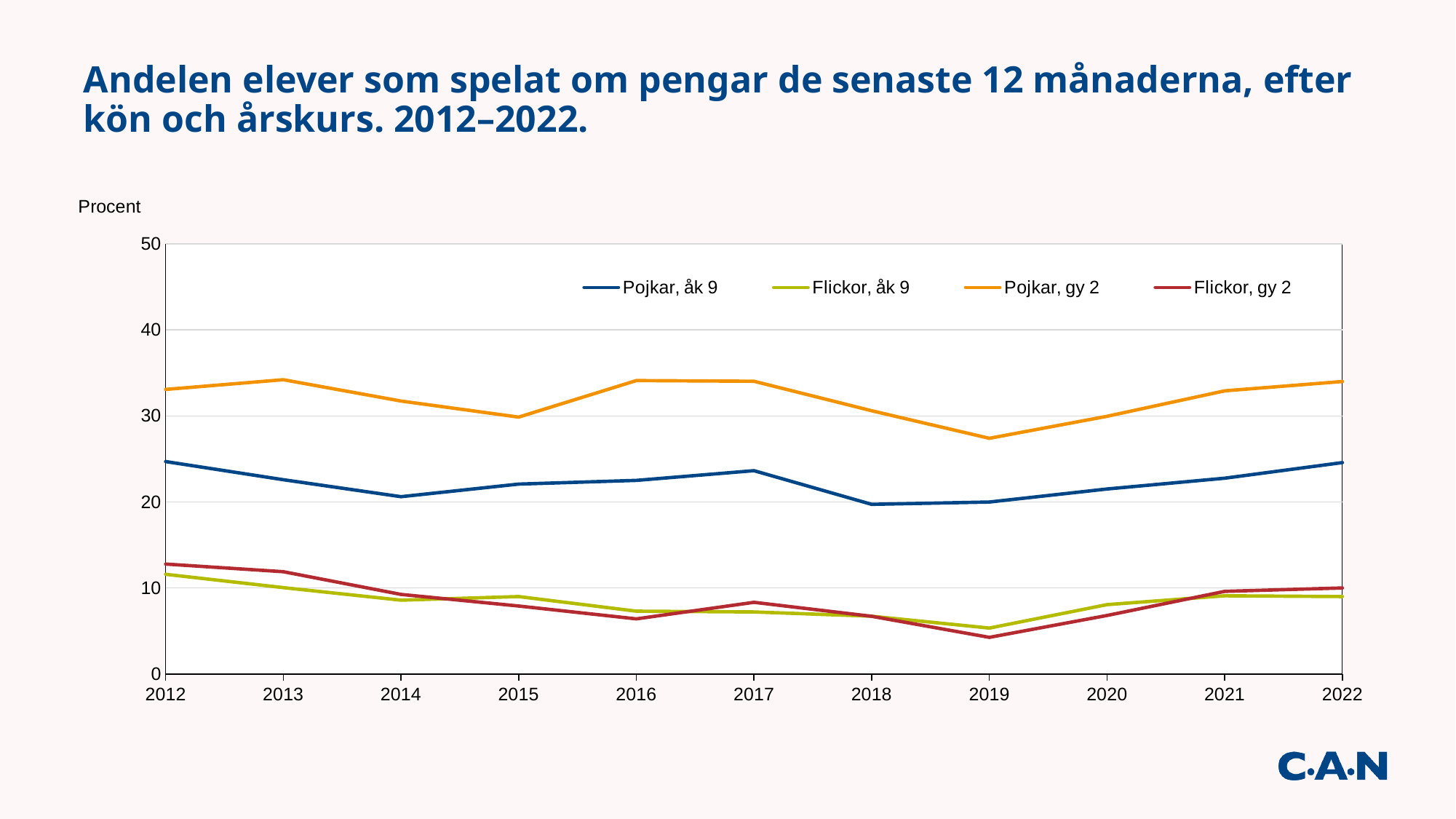
What kind of chart is shown on the slide? Line chart Does the Pojkar, gy 2 series rise or fall between 2017 and 2019? Fall In 2019, which is larger: Flickor, åk 9 or Flickor, gy 2? Flickor, åk 9 Is the value for Pojkar, gy 2 in 2013 greater or less than 30? greater Is the value for Pojkar, gy 2 in 2019 greater or less than 30? less Is the value for Flickor, gy 2 in 2019 greater or less than 10? less How many years are plotted along the x axis? 11 In which year does the Flickor, gy 2 series reach its highest value? 2012 How many series does the legend list? 4 Which series has the highest values across the whole period? Pojkar, gy 2 In which year does the Flickor, gy 2 series reach its lowest value? 2019 In which year does the Pojkar, gy 2 series reach its lowest value? 2019